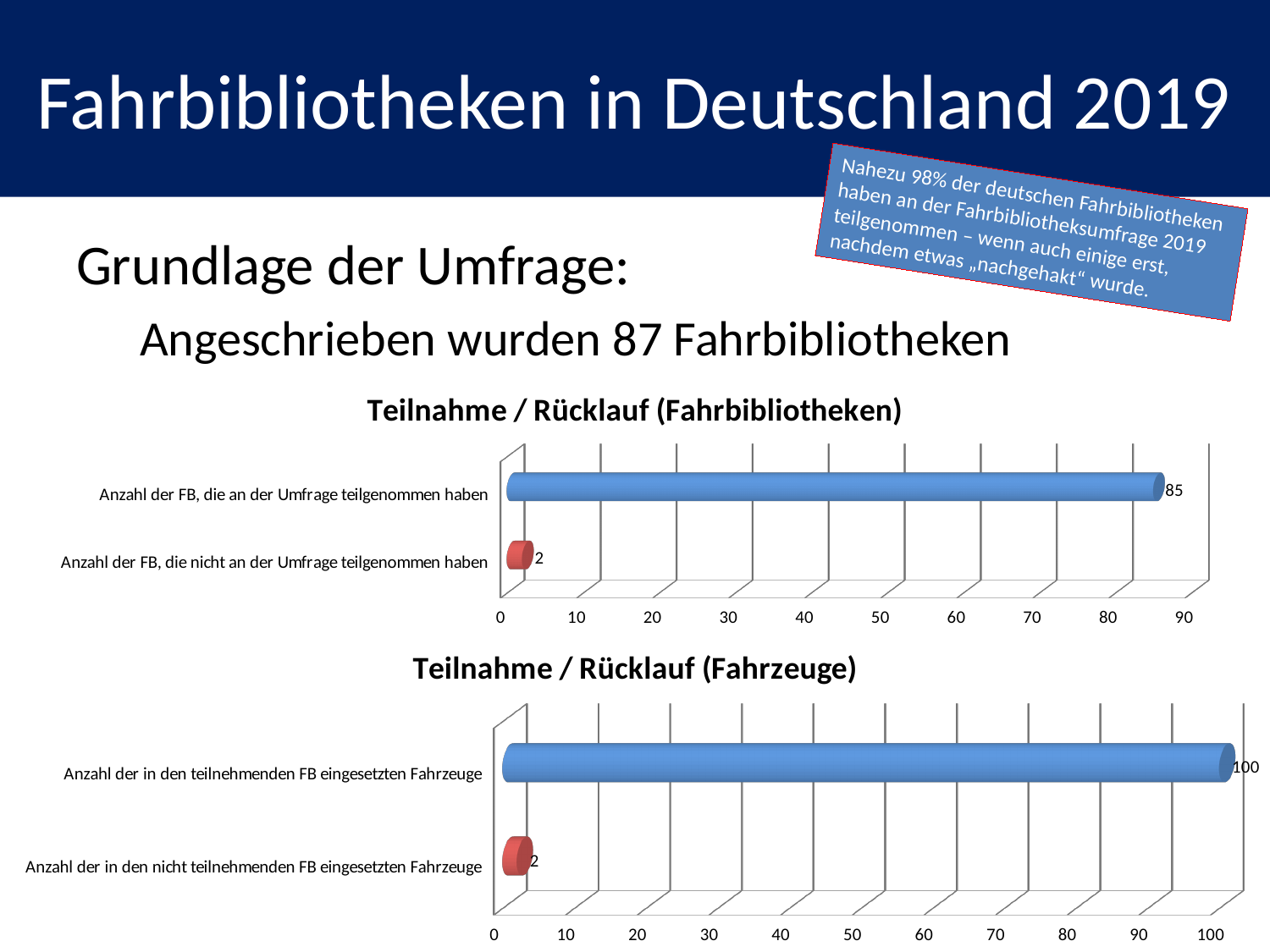
In the chart titled "Teilnahme / Rücklauf (Fahrbibliotheken)", is the value for "Anzahl der FB, die an der Umfrage teilgenommen haben" greater or less than 80? greater What kind of chart is the chart titled "Teilnahme / Rücklauf (Fahrbibliotheken)"? Bar chart In the chart titled "Teilnahme / Rücklauf (Fahrzeuge)", what is the value for "Anzahl der in den nicht teilnehmenden FB eingesetzten Fahrzeuge"? 2 In the chart titled "Teilnahme / Rücklauf (Fahrzeuge)", what is the value for "Anzahl der in den teilnehmenden FB eingesetzten Fahrzeuge"? 100 What is the title of the lower chart on the slide? Teilnahme / Rücklauf (Fahrzeuge) In the chart titled "Teilnahme / Rücklauf (Fahrbibliotheken)", what is the difference between the two bar values? 83 In the chart titled "Teilnahme / Rücklauf (Fahrzeuge)", which category has the lowest value? Anzahl der in den nicht teilnehmenden FB eingesetzten Fahrzeuge In the chart titled "Teilnahme / Rücklauf (Fahrbibliotheken)", which category has the highest value? Anzahl der FB, die an der Umfrage teilgenommen haben In the chart titled "Teilnahme / Rücklauf (Fahrzeuge)", what is the difference between the two bar values? 98 How many categories are shown in the chart titled "Teilnahme / Rücklauf (Fahrzeuge)"? 2 In the chart titled "Teilnahme / Rücklauf (Fahrbibliotheken)", what is the value for "Anzahl der FB, die nicht an der Umfrage teilgenommen haben"? 2 In the chart titled "Teilnahme / Rücklauf (Fahrbibliotheken)", what is the value for "Anzahl der FB, die an der Umfrage teilgenommen haben"? 85